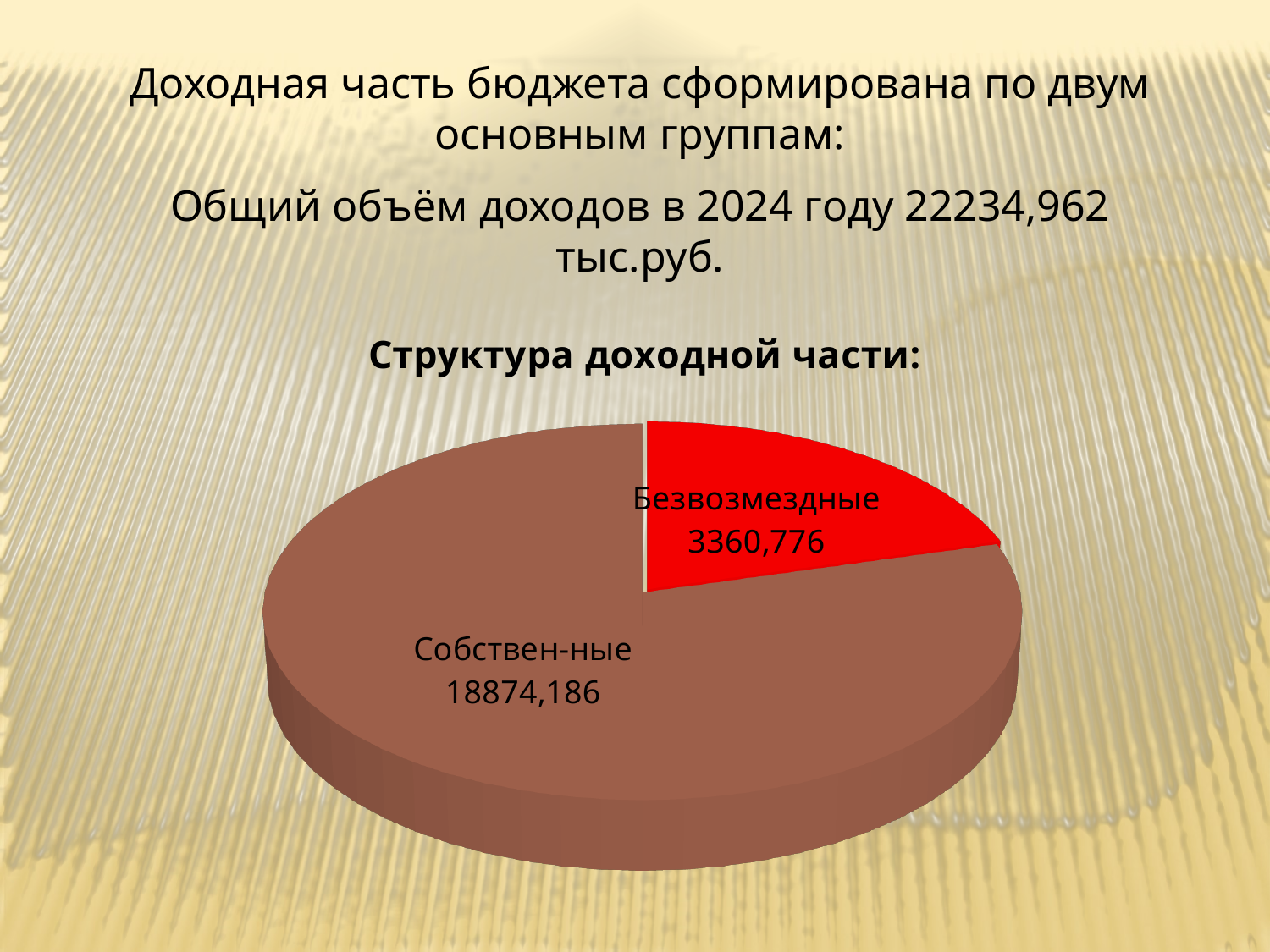
Which slice of the pie is the smallest? Безвозмездные Which slice of the pie is the largest? Собствен-ные What is the total of the two slices in the pie chart? 22234,962 How many slices does the pie chart have? 2 What is the title of the pie chart? Структура доходной части: What is the difference between the Собствен-ные and Безвозмездные values? 15513,410 What is the value of the Собствен-ные slice? 18874,186 What share of the pie does the Безвозмездные slice represent? 15.1% What is the value of the Безвозмездные slice? 3360,776 What colour is the Безвозмездные slice? red Which is larger, Собствен-ные or Безвозмездные? Собствен-ные What type of chart is shown on the slide? pie chart